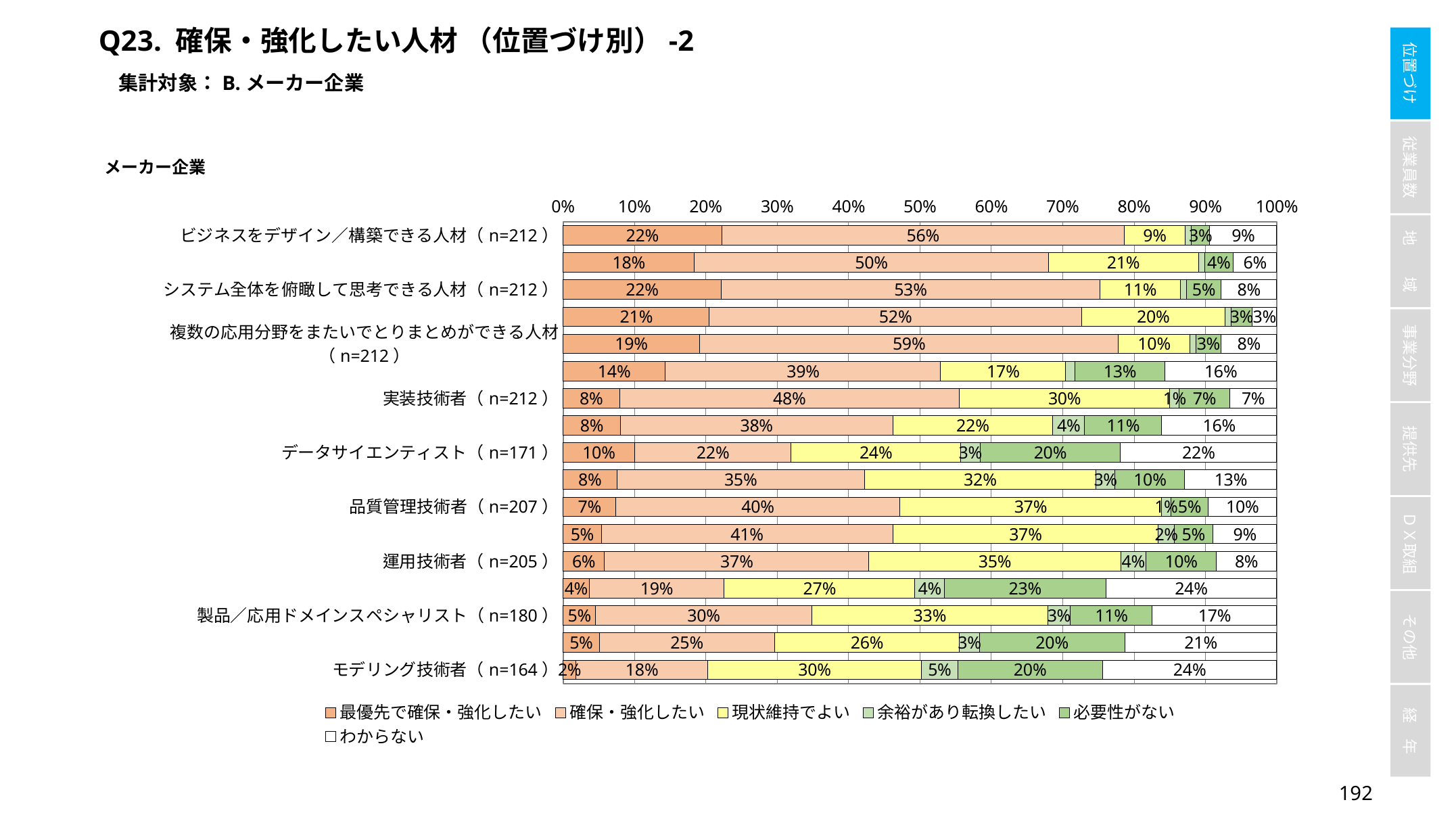
What is the 最優先で確保・強化したい value for データサイエンティスト (n=171)? 10% How many series does the legend list? 6 What is the first entry in the chart's legend? 最優先で確保・強化したい Which has the larger 確保・強化したい value: ビジネスをデザイン／構築できる人材 or システム全体を俯瞰して思考できる人材? ビジネスをデザイン／構築できる人材 What is the sample size (n) shown for モデリング技術者? 164 What is the difference between the 必要性がない values for データサイエンティスト (n=171) and 製品／応用ドメインスペシャリスト (n=180)? 9 percentage points What is the 必要性がない value for 運用技術者 (n=205)? 10% What is the わからない value for モデリング技術者 (n=164)? 24% What kind of chart is shown on the slide? stacked bar chart What is the 確保・強化したい value for 実装技術者 (n=212)? 48% What is the 確保・強化したい value for 複数の応用分野をまたいでとりまとめができる人材 (n=212)? 59% What is the 現状維持でよい value for 品質管理技術者 (n=207)? 37%